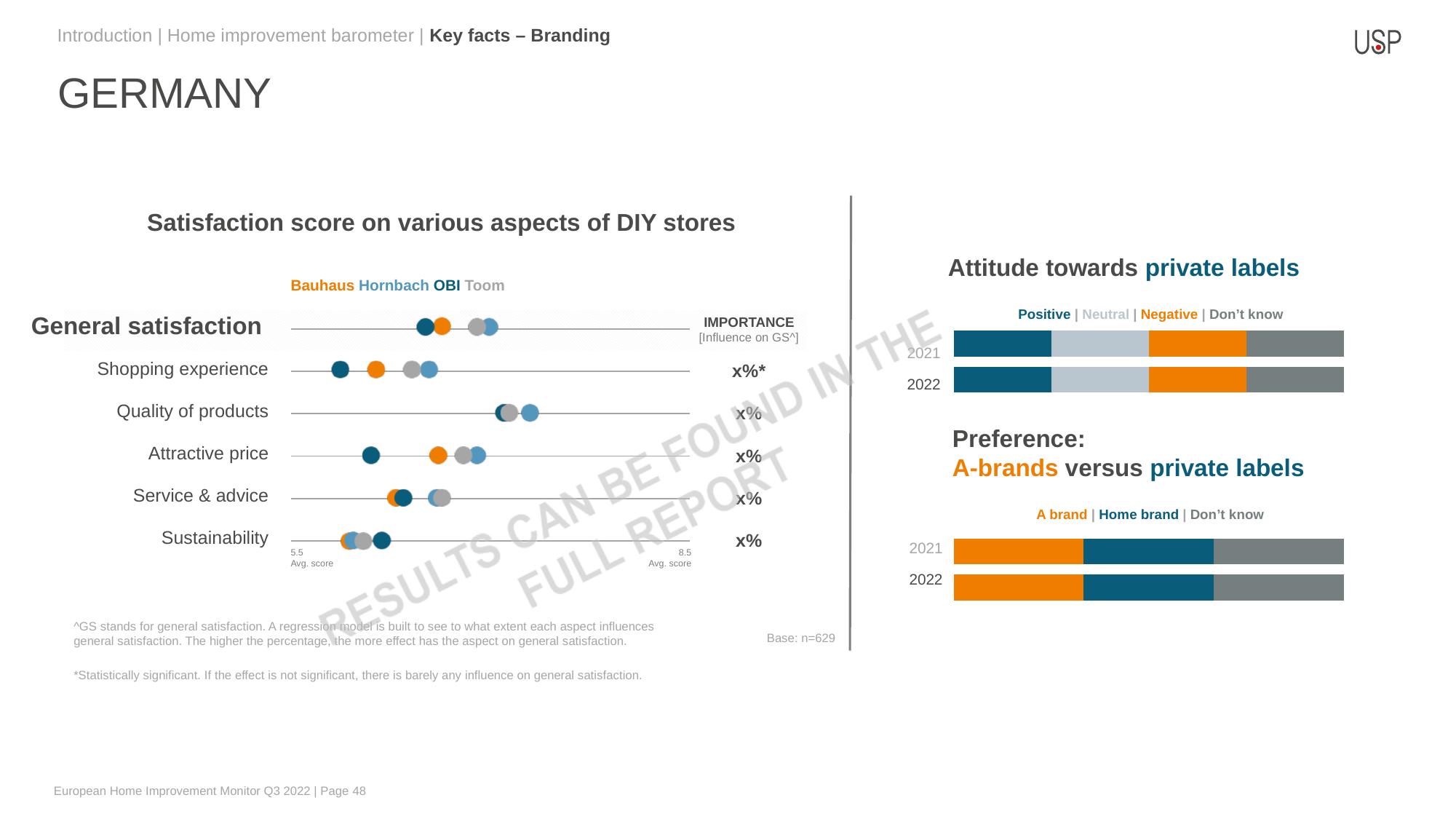
What kind of chart is the 'Attitude towards private labels' chart? Stacked bar chart Which years are shown in the 'Preference: A-brands versus private labels' chart? 2021 and 2022 How many aspects (rows) are plotted in the 'Satisfaction score on various aspects of DIY stores' chart? 6 In the 'Satisfaction score on various aspects of DIY stores' chart, which brand has the lowest score for Shopping experience? OBI In the 'Satisfaction score on various aspects of DIY stores' chart, which brand has the lowest score for Attractive price? OBI How many bars are there in the 'Attitude towards private labels' chart? 2 In the 'Satisfaction score on various aspects of DIY stores' chart, which brand has the lowest score for General satisfaction? OBI How many series does the legend of the 'Attitude towards private labels' chart list? 4 How many series does the legend of the 'Preference: A-brands versus private labels' chart list? 3 In the 'Satisfaction score on various aspects of DIY stores' chart, which brand has the highest score for Quality of products? Hornbach How many brands does the legend of the 'Satisfaction score on various aspects of DIY stores' chart list? 4 What is the base (sample size) shown for the 'Satisfaction score on various aspects of DIY stores' chart? n=629